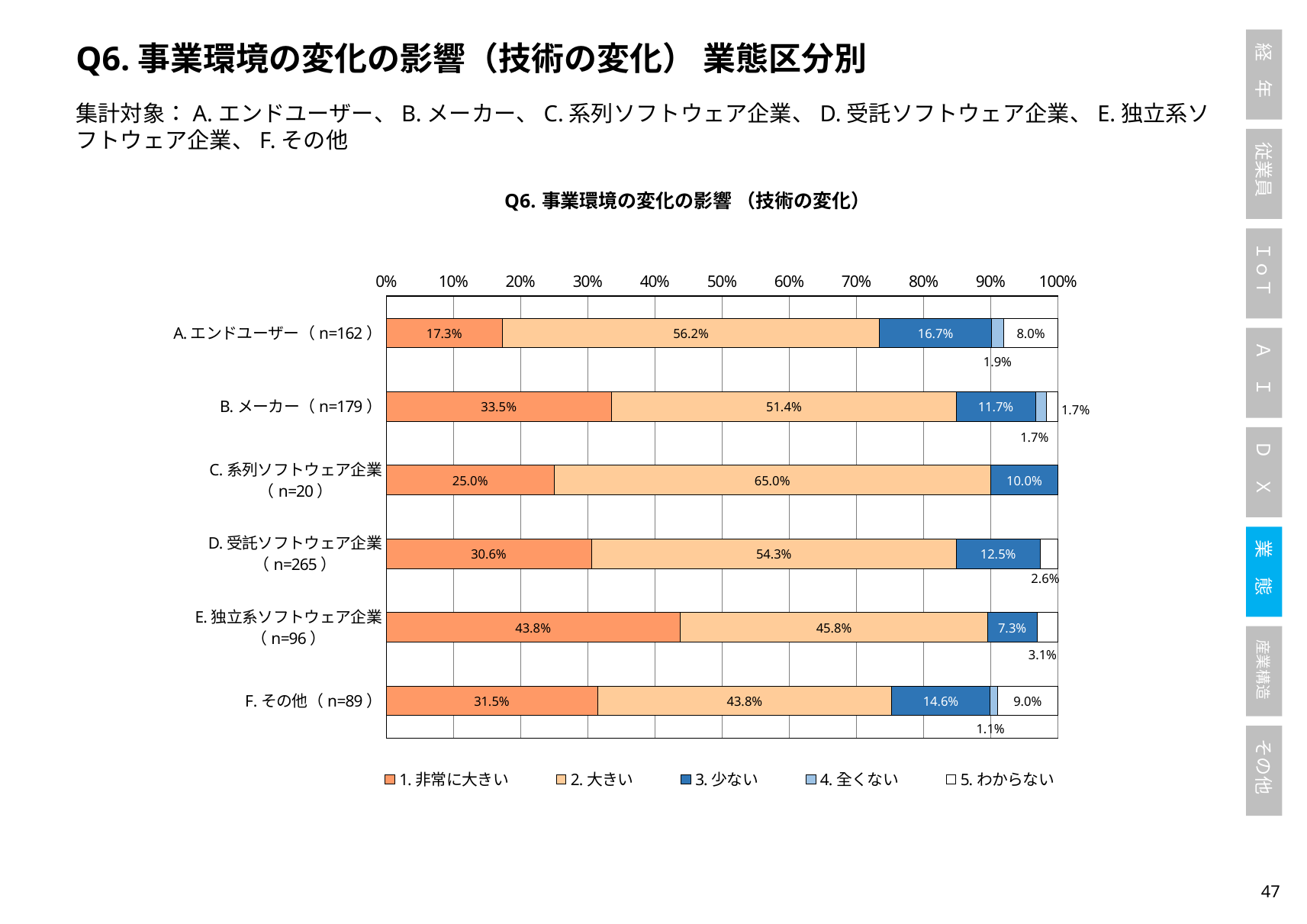
How many series does the legend list? 5 What type of chart is shown on the slide? Stacked bar chart What is the value of 1. 非常に大きい for E. 独立系ソフトウェア企業? 43.8% What is the value of 3. 少ない for A. エンドユーザー? 16.7% What is the value of 5. わからない for F. その他? 9.0% Which is larger: the 3. 少ない value for D. 受託ソフトウェア企業 or for B. メーカー? D. 受託ソフトウェア企業 Which category has the lowest value for 2. 大きい? F. その他 Which category has the highest value for 1. 非常に大きい? E. 独立系ソフトウェア企業 What is the sample size (n) shown for D. 受託ソフトウェア企業? 265 What is the value of 2. 大きい for C. 系列ソフトウェア企業? 65.0% How many business categories are plotted on the chart? 6 What is the difference between the 1. 非常に大きい values for B. メーカー and A. エンドユーザー? 16.2%